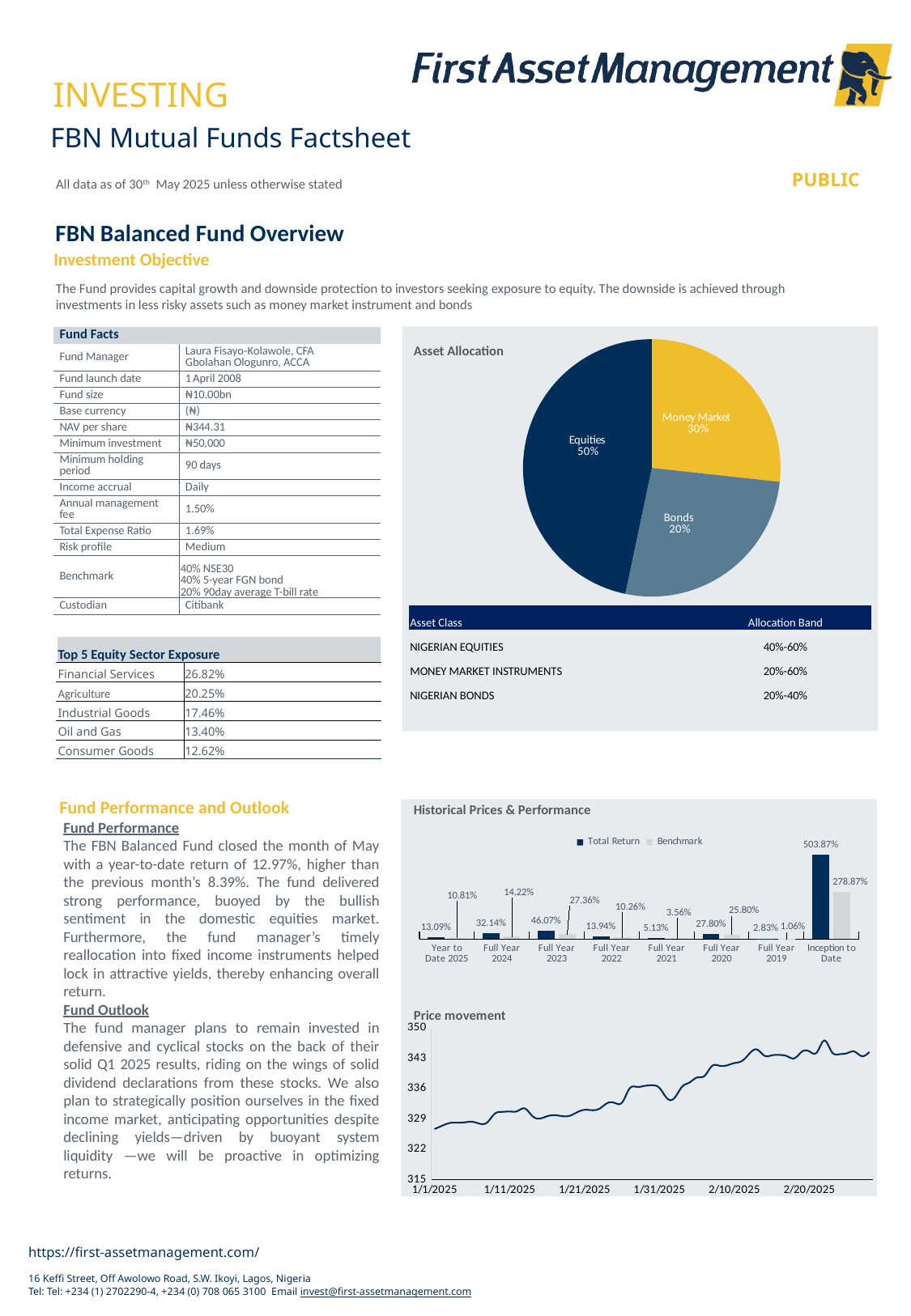
On the Historical Prices & Performance chart, what is the difference between the Total Return and the Benchmark for Full Year 2024? 17.92% On the Historical Prices & Performance chart, which period has the lowest Total Return? Full Year 2019 On the Price movement chart, is the value at 1/1/2025 greater or less than 336? less On the Asset Allocation pie chart, how many slices are shown? 3 On the Historical Prices & Performance chart, how many series does the legend list? 2 On the Asset Allocation pie chart, which asset class has the largest slice? Equities On the Asset Allocation pie chart, what share is allocated to Equities? 50% On the Historical Prices & Performance chart, what is the Total Return for Inception to Date? 503.87% On the Historical Prices & Performance chart, what is the Benchmark value for Full Year 2023? 27.36% On the Asset Allocation pie chart, what share is allocated to Bonds? 20% On the Historical Prices & Performance chart, which is larger for Full Year 2021: the Total Return or the Benchmark? Total Return What kind of chart is the Price movement chart? Line chart